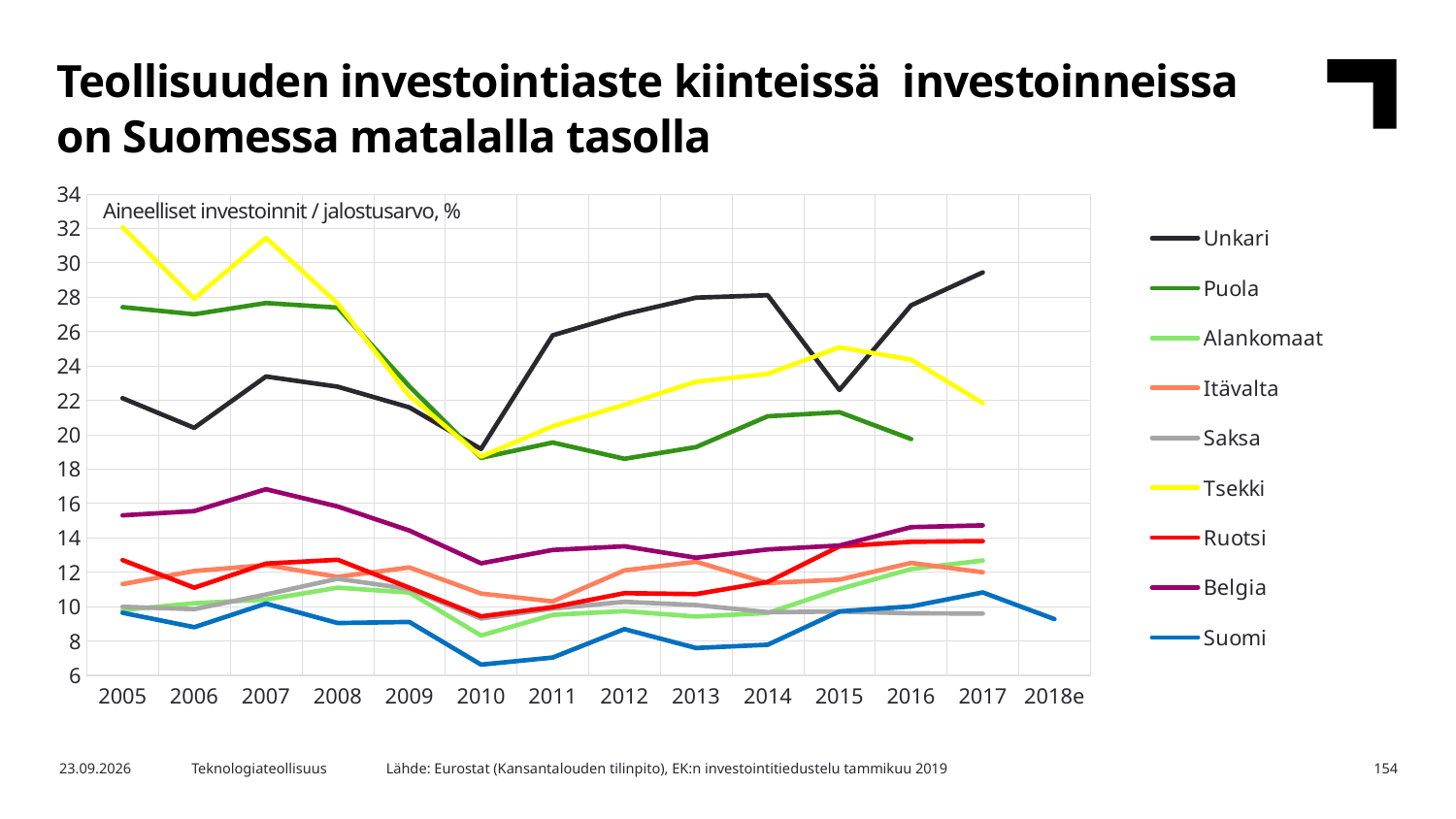
Does the value for Tsekki rise or fall from 2005 to 2010? fall In 2017, which is higher, Unkari or Tsekki? Unkari Which country has the lowest value in 2010? Suomi What is the label written inside the top-left corner of the plot area? Aineelliset investoinnit / jalostusarvo, % Is the value for Unkari in 2017 greater or less than 28? greater How many series does the legend list? 9 In 2005, which is higher, Puola or Unkari? Puola Is the value for Belgia in 2007 greater or less than 16? greater What kind of chart is shown on the slide? line chart Is the value for Suomi in 2010 greater or less than 8? less Which country has the highest value in 2005? Tsekki How many years are shown on the x axis? 14